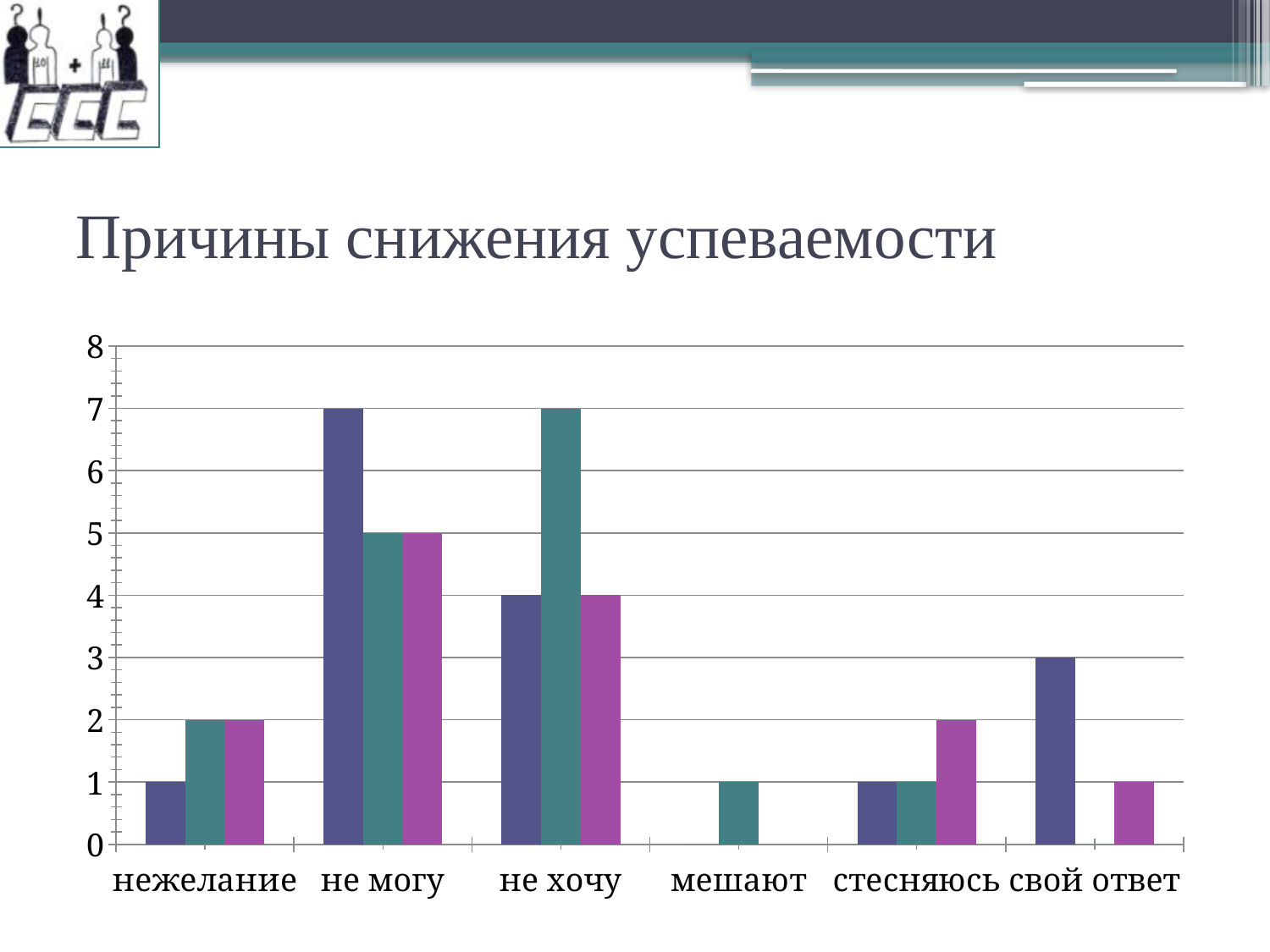
What is the value of the magenta bar for "стесняюсь"? 2 What is the value of the dark blue bar for "свой ответ"? 3 What is the value of the dark blue bar for "не могу"? 7 Which category has the highest teal bar? не хочу What kind of chart is shown on the slide? bar chart How many categories are shown on the x axis of the chart? 6 What is the title of the chart? Причины снижения успеваемости Which is larger for "не хочу": the dark blue bar or the teal bar? the teal bar What is the value of the teal bar for "мешают"? 1 Which category has the highest dark blue bar? не могу What is the difference between the dark blue bar and the teal bar for "не могу"? 2 What is the value of the teal bar for "не хочу"? 7